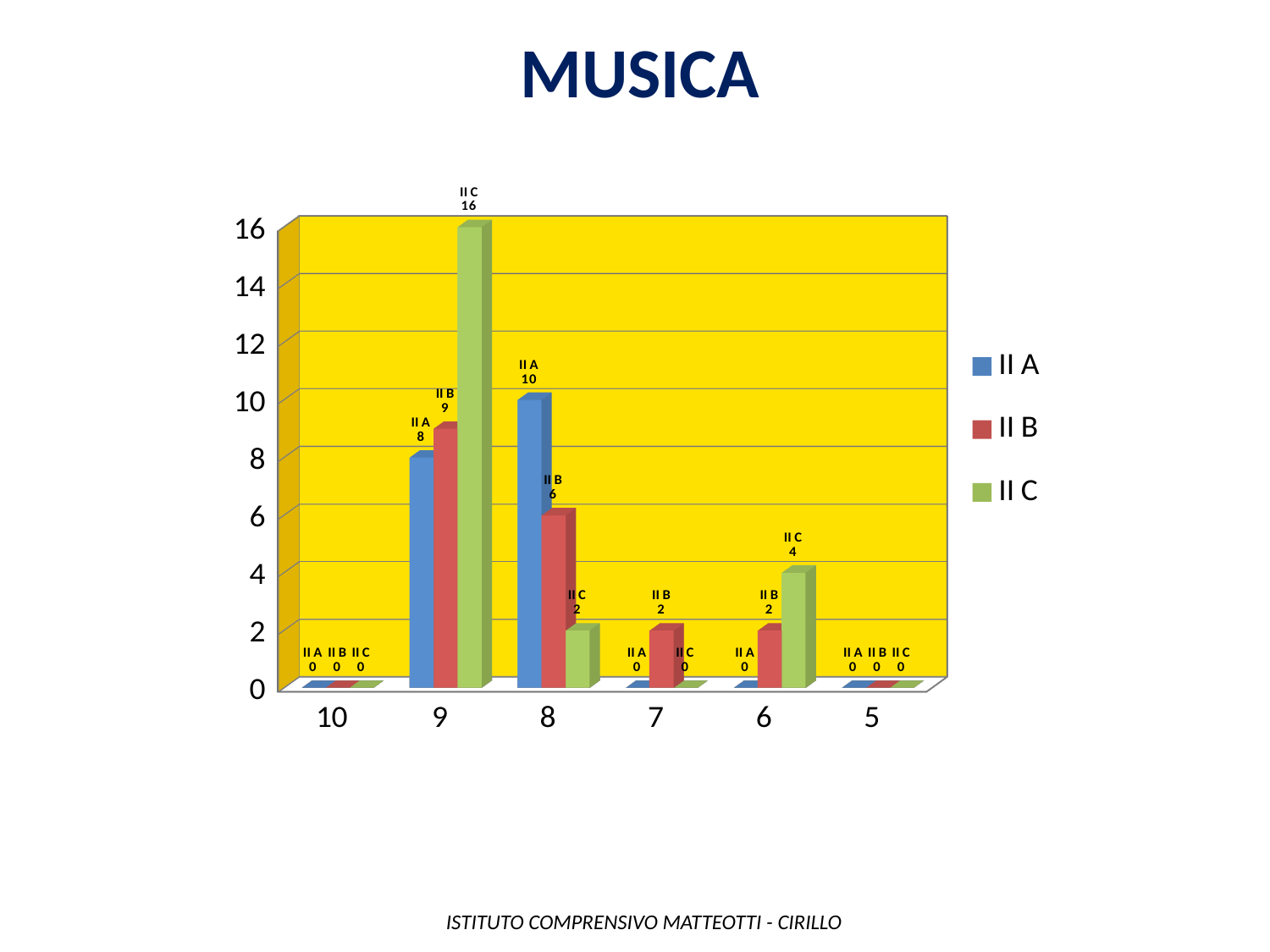
What is the title of the chart? MUSICA What is the value for II C at grade 9? 16 What is the value for II A at grade 8? 10 Which is larger at grade 9: II A or II B? II B What kind of chart is shown on the slide? bar chart Which series has the highest value at grade 9? II C Which series has the lowest value at grade 8? II C What is the value for II B at grade 6? 2 How many series does the legend list? 3 How many categories are shown on the x axis? 6 What is the total of the three series at grade 9? 33 What is the difference between II A and II B at grade 8? 4